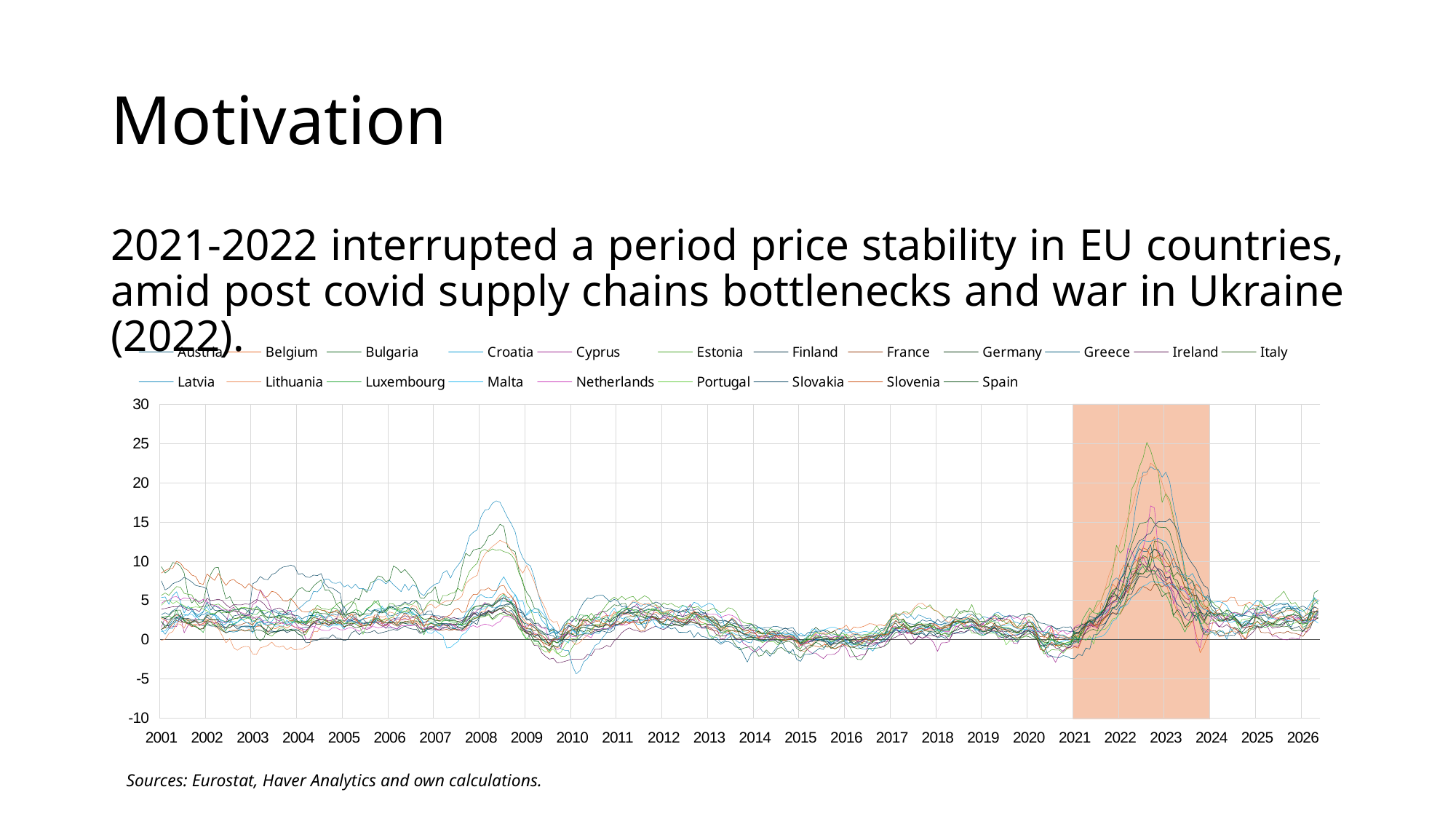
How many year labels are shown along the x axis? 26 Is the lowest value reached by any line around 2010 greater or less than 0? less Do the lines generally rise or fall between 2021 and the end of 2022? rise What is the lowest value shown on the chart's vertical axis? -10 How many series (countries) does the chart legend list? 21 Is the highest peak reached by any line around 2008 greater or less than 20? less What is the highest value shown on the chart's vertical axis? 30 What kind of chart is shown on the slide? line chart Do the lines generally rise or fall between early 2023 and 2024? fall Is the highest peak reached by any line in the shaded 2022-2023 period greater or less than 20? greater Which period shows the higher peak across the lines: around 2008 or around 2022-2023? around 2022-2023